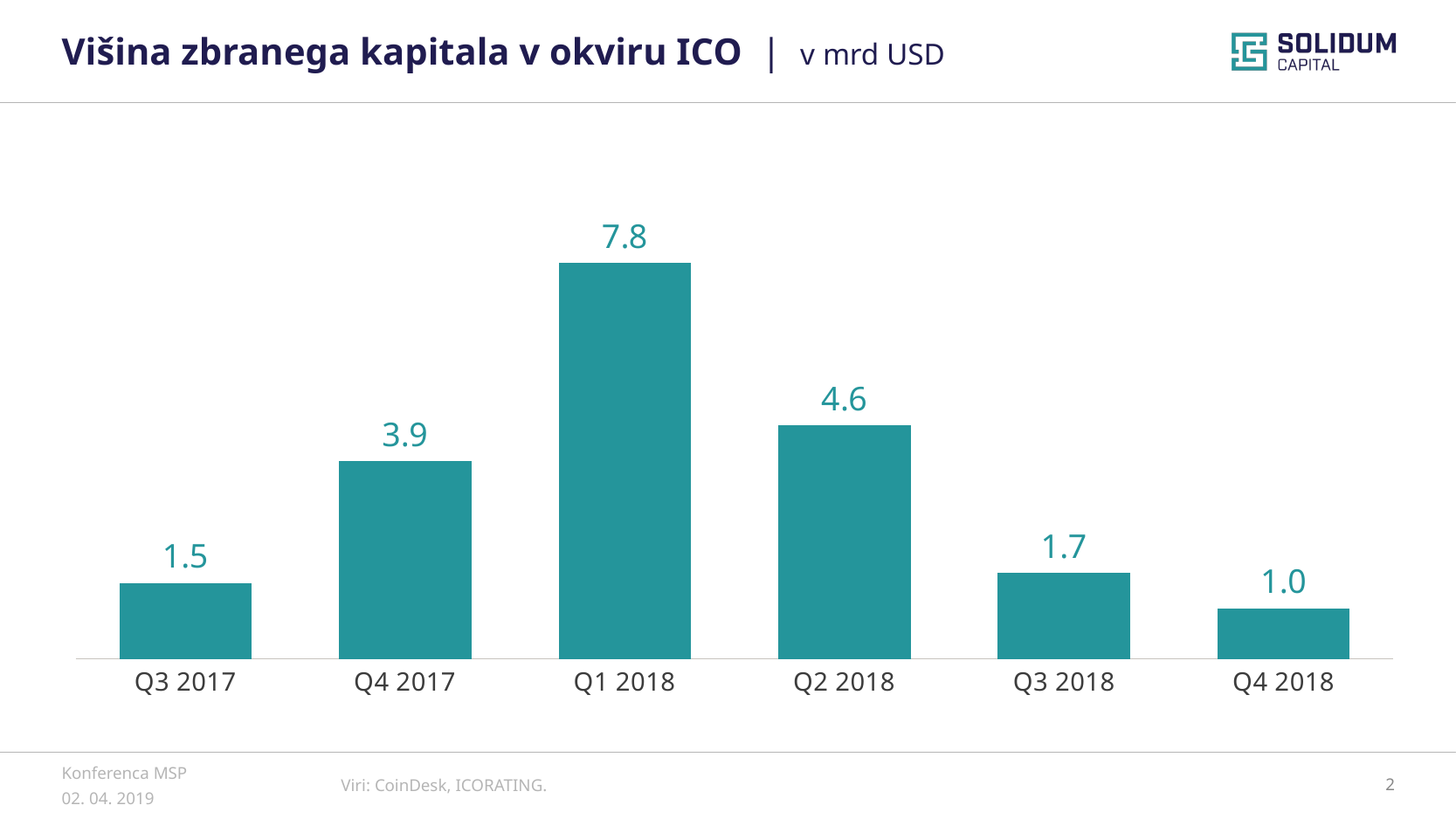
What is the difference between the values for Q4 2017 and Q3 2018? 2.2 In what unit are the values on the chart expressed, according to the title? mrd USD What is the value for Q1 2018? 7.8 What kind of chart is shown on the slide? Bar chart Which quarter has the highest value? Q1 2018 What is the value for Q3 2017? 1.5 Which is larger, the value for Q4 2017 or the value for Q2 2018? Q2 2018 What is the difference between the values for Q1 2018 and Q2 2018? 3.2 What is the value for Q4 2018? 1.0 How many quarters are shown on the chart? 6 Which quarter has the lowest value? Q4 2018 Do the values rise or fall from Q1 2018 to Q4 2018? Fall